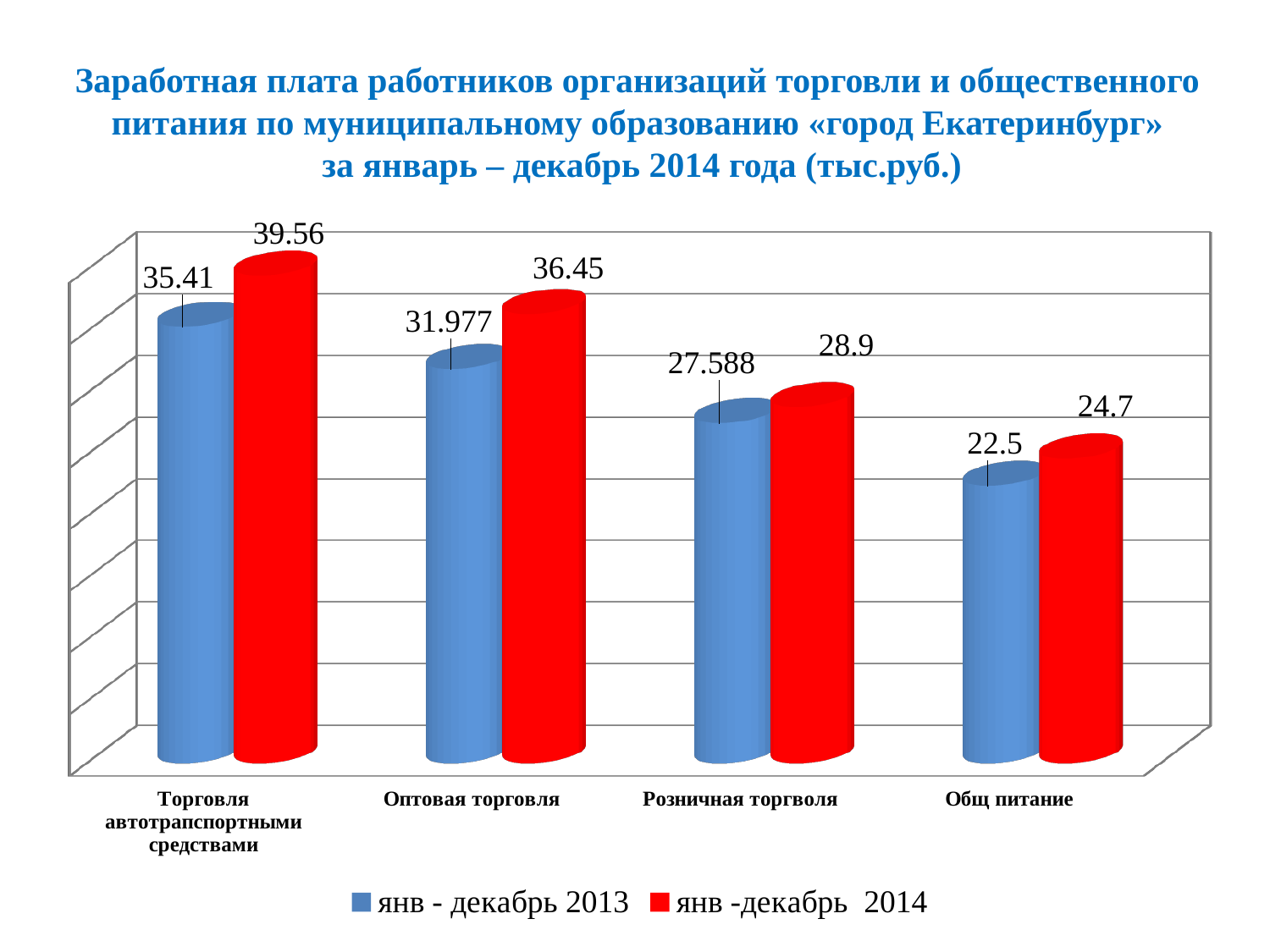
How many series does the legend list? 2 What kind of chart is shown on the slide? bar chart How many categories are shown on the x axis? 4 Do the values in the янв -декабрь 2014 series rise or fall from left to right along the x axis? fall What is the value for Розничная торгволя in the янв -декабрь 2014 series? 28.9 What is the difference between the 2014 and 2013 values for Общ питание? 2.2 What is the value for Общ питание in the янв -декабрь 2014 series? 24.7 Which category has the lowest value in the янв - декабрь 2013 series? Общ питание What is the difference between the 2014 and 2013 values for Торговля автотраспортными средствами? 4.15 Which is larger: the 2013 value for Оптовая торговля or the 2014 value for Розничная торгволя? the 2013 value for Оптовая торговля Which category has the highest value in the янв -декабрь 2014 series? Торговля автотрапспортными средствами What is the value for Оптовая торговля in the янв - декабрь 2013 series? 31.977